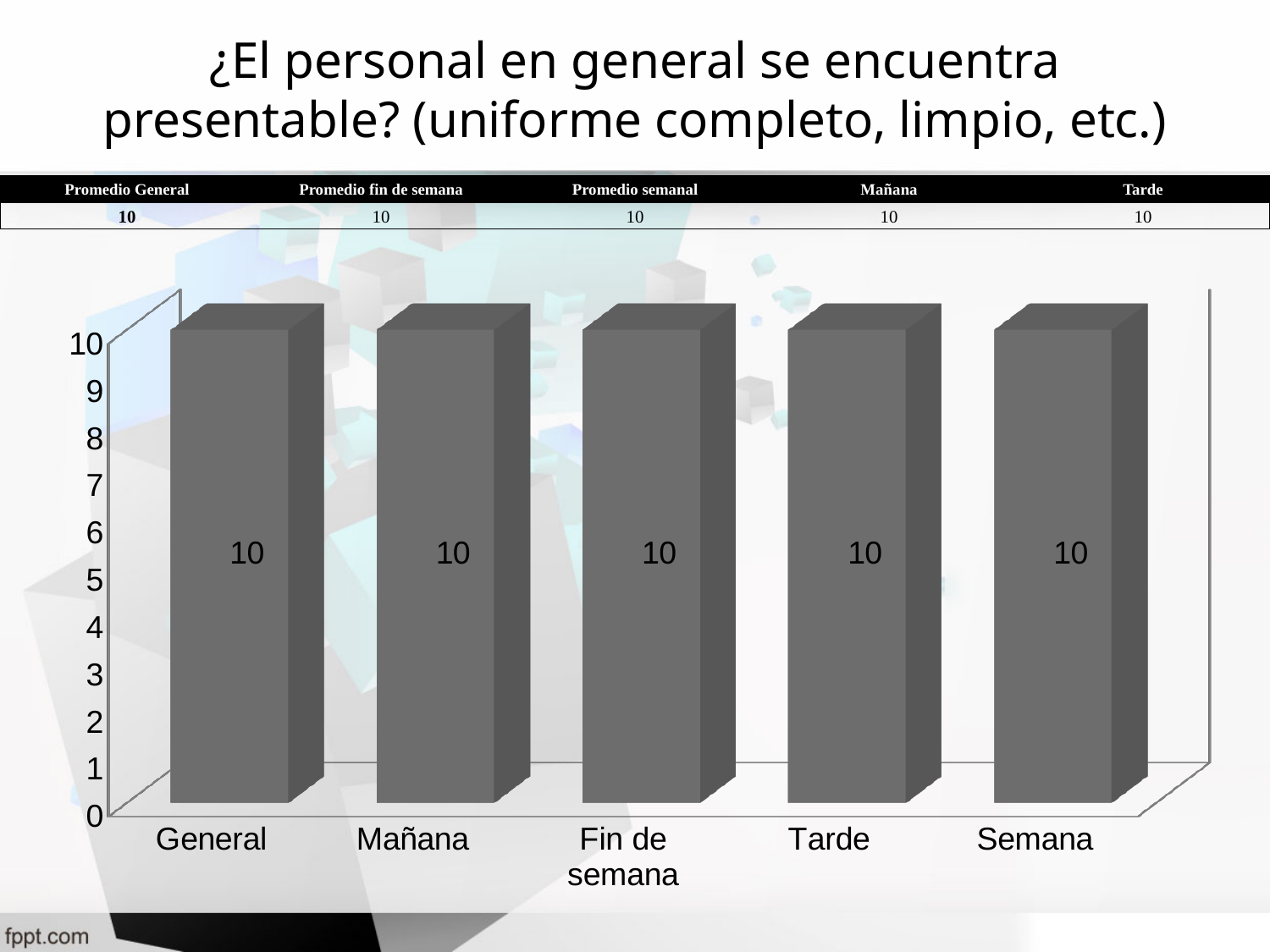
Do the values rise, fall, or stay the same across the categories from General to Semana? stay the same What is the value for Tarde? 10 What is the value for Semana? 10 What is the difference between the values for General and Tarde? 0 What is the highest value shown on the vertical axis of the chart? 10 What is the value for General? 10 What kind of chart is shown on the slide? bar chart What is the value for Mañana? 10 Is the value for Mañana greater or less than 5? greater How many categories are shown on the x axis of the chart? 5 What is the label of the third category on the x axis? Fin de semana What is the value for Fin de semana? 10